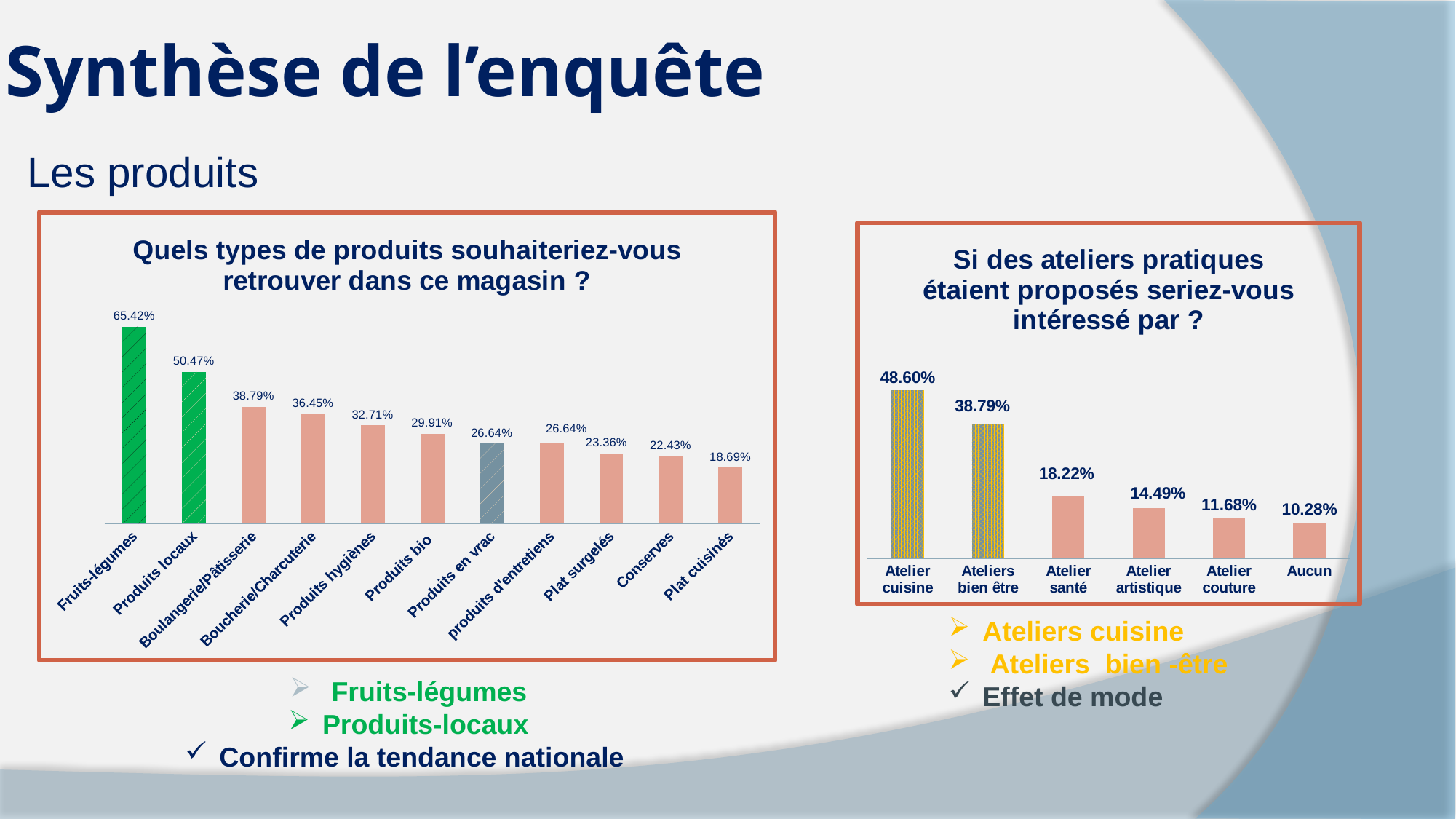
In the chart 'Quels types de produits souhaiteriez-vous retrouver dans ce magasin ?', which category has the lowest value? Plat cuisinés In the chart 'Quels types de produits souhaiteriez-vous retrouver dans ce magasin ?', what is the difference between Fruits-légumes and Produits locaux? 14.95% In the chart 'Quels types de produits souhaiteriez-vous retrouver dans ce magasin ?', what is the value for Produits en vrac? 26.64% In the chart 'Si des ateliers pratiques étaient proposés seriez-vous intéressé par ?', what is the difference between Atelier cuisine and Ateliers bien être? 9.81% In the chart 'Si des ateliers pratiques étaient proposés seriez-vous intéressé par ?', how many categories are shown? 6 In the chart 'Quels types de produits souhaiteriez-vous retrouver dans ce magasin ?', which is larger: Boulangerie/Pâtisserie or Boucherie/Charcuterie? Boulangerie/Pâtisserie In the chart 'Quels types de produits souhaiteriez-vous retrouver dans ce magasin ?', do the values rise or fall from left to right? fall In the chart 'Si des ateliers pratiques étaient proposés seriez-vous intéressé par ?', which category has the highest value? Atelier cuisine What type of chart is the chart 'Si des ateliers pratiques étaient proposés seriez-vous intéressé par ?'? bar chart In the chart 'Si des ateliers pratiques étaient proposés seriez-vous intéressé par ?', what is the value for Atelier santé? 18.22% In the chart 'Quels types de produits souhaiteriez-vous retrouver dans ce magasin ?', what is the value for Fruits-légumes? 65.42% In the chart 'Quels types de produits souhaiteriez-vous retrouver dans ce magasin ?', how many categories are shown? 11